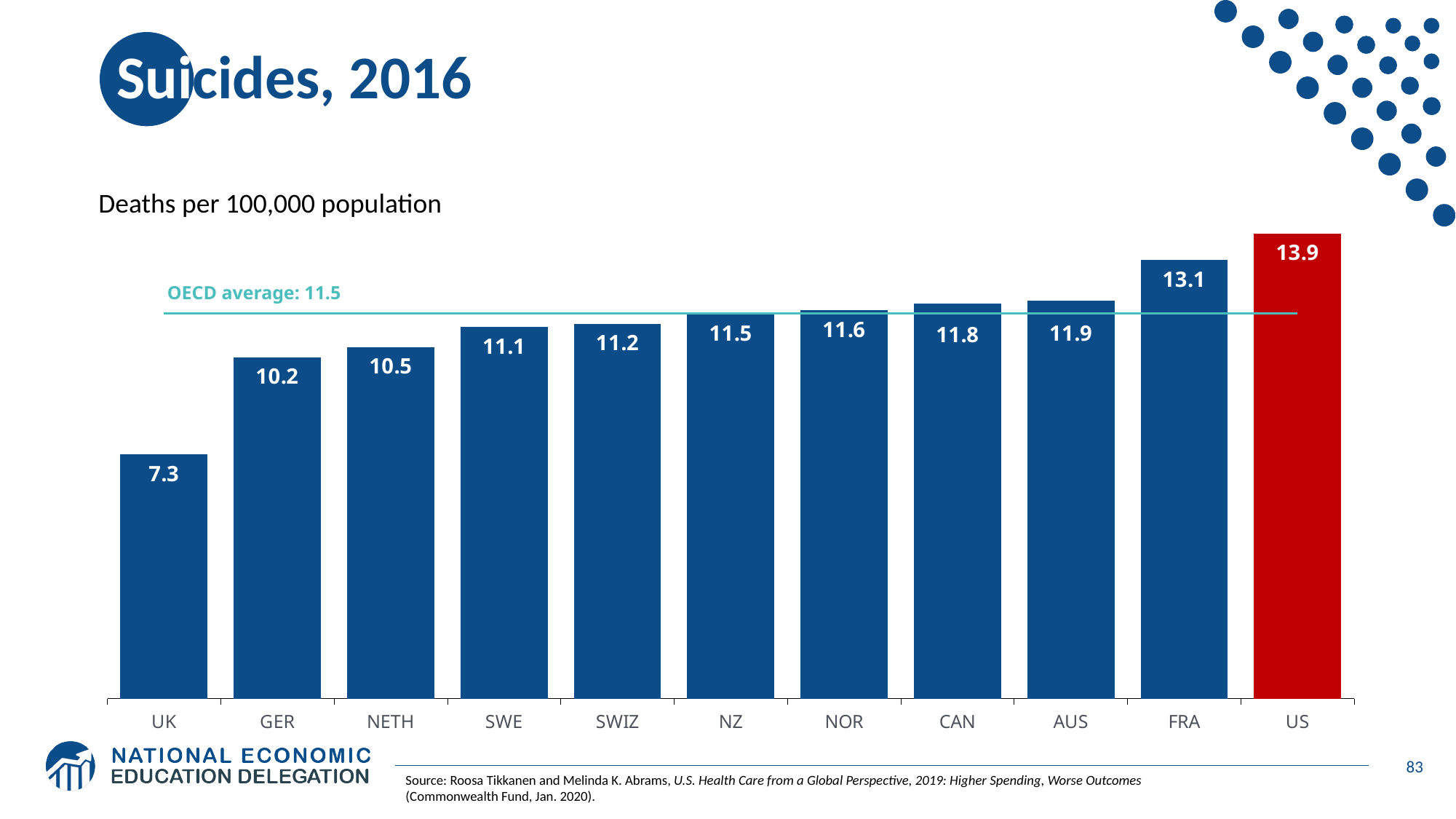
How many countries are shown on the chart? 11 What is the suicide rate (deaths per 100,000 population) for the US? 13.9 What is the difference between the US value and the UK value? 6.6 What is the difference between the FRA value and the AUS value? 1.2 Which country has the lowest suicide rate on the chart? UK Which country has the highest suicide rate on the chart? US Which has a higher suicide rate, Canada (CAN) or Sweden (SWE)? CAN What is the value shown for Germany (GER)? 10.2 Do the values rise or fall moving from left to right across the chart? Rise What kind of chart is shown on the slide? Bar chart What OECD average value is marked by the horizontal line on the chart? 11.5 What is the value shown for Norway (NOR)? 11.6